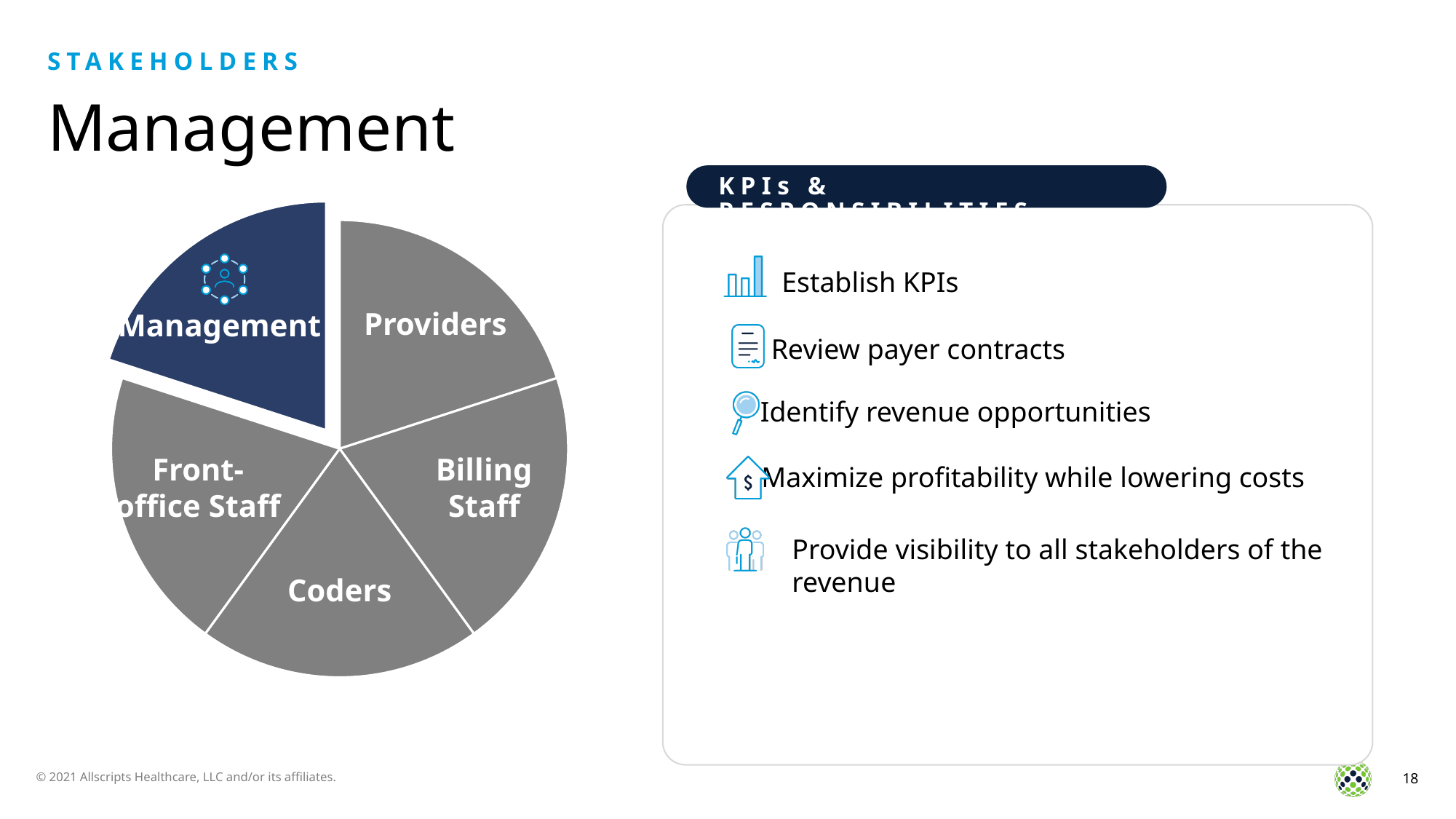
Which slice of the pie chart is labelled at the bottom of the pie? Coders Does the pie chart print any percentage or numeric values on its slices? No How many slices does the pie chart have? 5 Which slice of the pie chart lies between Providers and Coders? Billing Staff Which slice of the pie chart lies between Management and Coders on the left side of the pie? Front-office Staff What kind of chart is shown on the left of the slide? pie chart Which slice of the pie chart is pulled out (exploded) from the rest of the pie? Management Which slice of the pie chart sits directly to the right of the Management slice? Providers Which slice of the pie chart is coloured dark blue rather than grey? Management